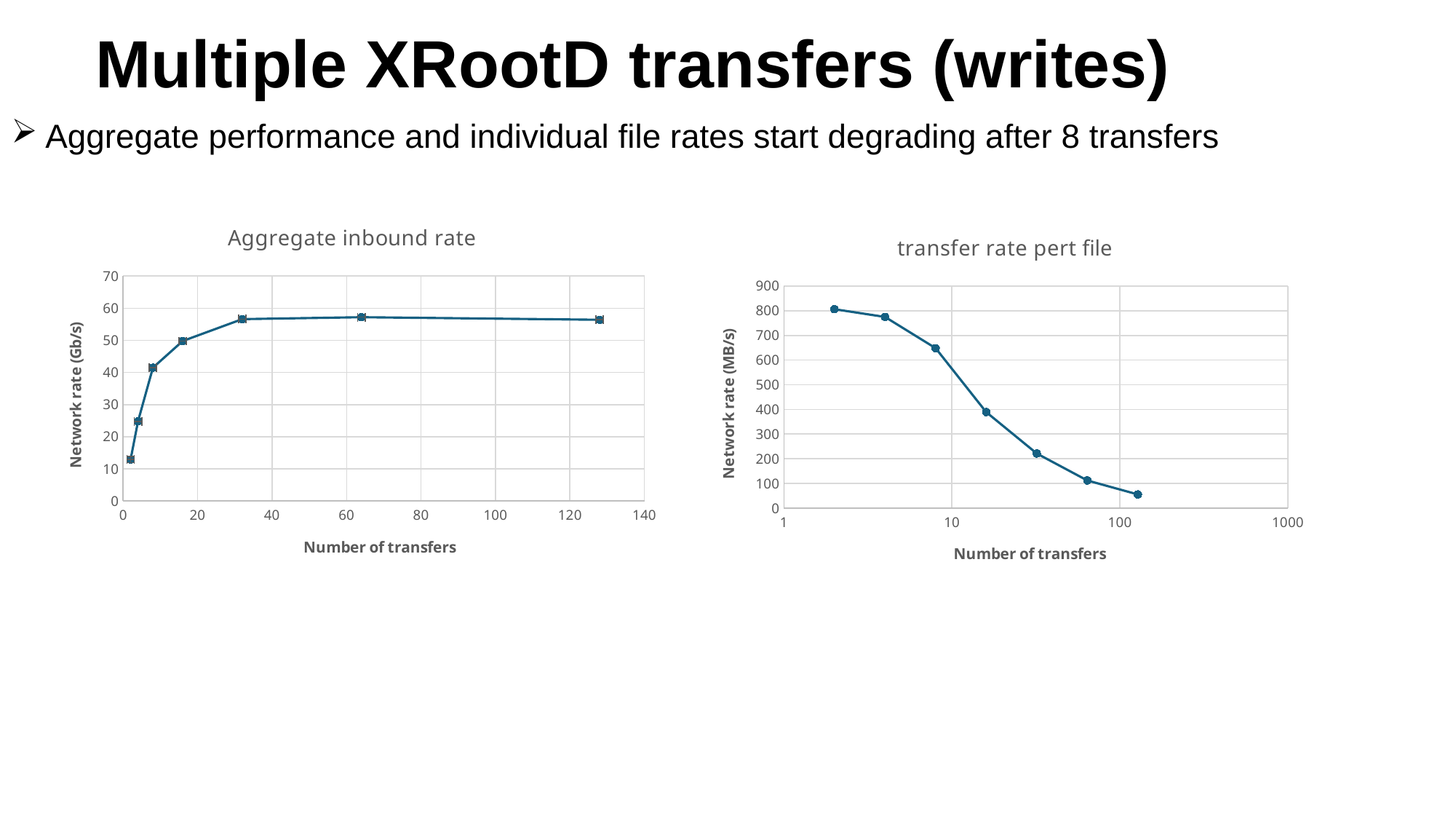
In the 'transfer rate pert file' chart, which number of transfers has the lowest network rate? 128 What is the y-axis label of the 'Aggregate inbound rate' chart? Network rate (Gb/s) In the 'transfer rate pert file' chart, do the values rise or fall as the number of transfers increases? fall In the 'Aggregate inbound rate' chart, how many data points are plotted? 7 In the 'transfer rate pert file' chart, is the network rate at 128 transfers greater or less than 100 MB/s? less In the 'transfer rate pert file' chart, is the network rate at 2 transfers greater or less than 700 MB/s? greater What is the x-axis label of the 'transfer rate pert file' chart? Number of transfers What kind of chart is the 'Aggregate inbound rate' chart on the left? line chart In the 'transfer rate pert file' chart, how many data points are plotted? 7 In the 'Aggregate inbound rate' chart, is the network rate at 2 transfers greater or less than 20 Gb/s? less What kind of chart is the 'transfer rate pert file' chart on the right? line chart